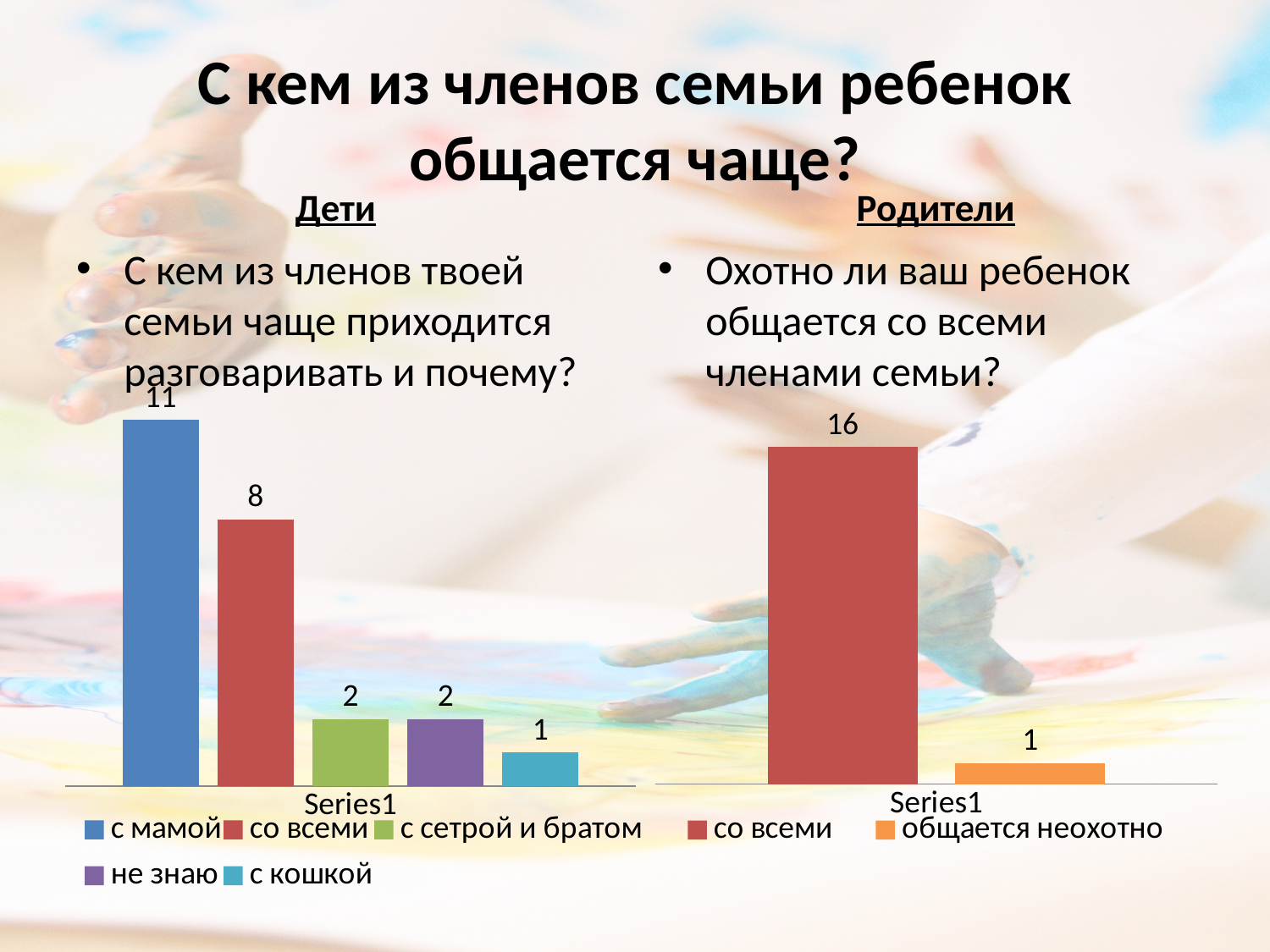
In the left chart (Дети), which series has the lowest value? с кошкой In the left chart (Дети), how many series does the legend list? 5 In the left chart (Дети), what is the difference between 'с мамой' and 'со всеми'? 3 In the left chart (Дети), which series has the highest value? с мамой In the right chart (Родители), what is the value for 'со всеми'? 16 In the left chart (Дети), what is the value for 'с кошкой'? 1 What kind of chart is the right chart (Родители)? bar chart In the right chart (Родители), what is the value for 'общается неохотно'? 1 In the right chart (Родители), which is larger: 'со всеми' or 'общается неохотно'? со всеми In the left chart (Дети), what is the value for 'со всеми'? 8 In the left chart (Дети), what is the value for 'с мамой'? 11 In the right chart (Родители), what is the difference between 'со всеми' and 'общается неохотно'? 15